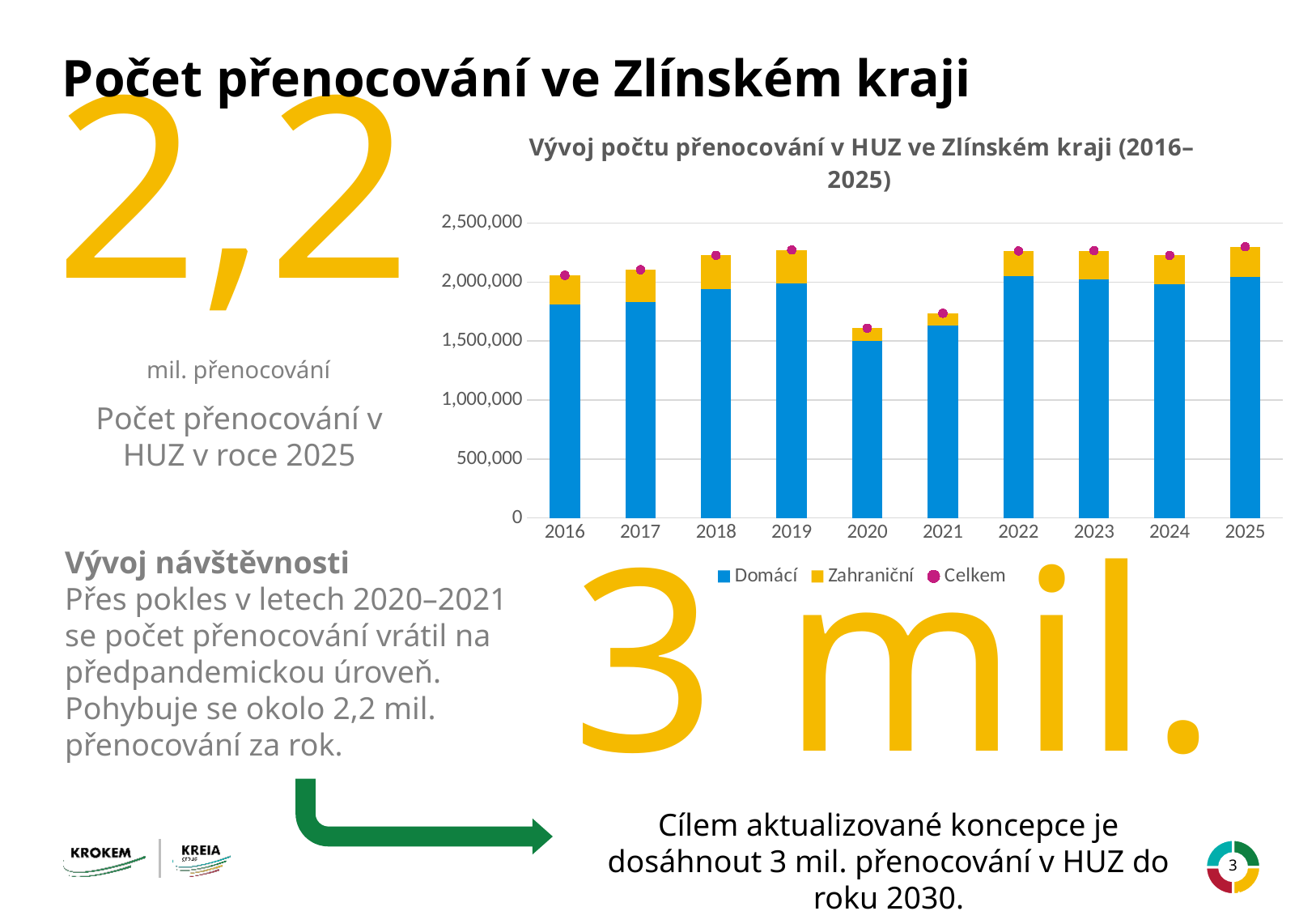
How many series does the chart legend list? 3 Do the total (Celkem) values rise or fall from 2016 to 2019? rise Is the total (Celkem) value for 2020 greater or less than 2,000,000? less What kind of chart is shown on the slide? bar chart What is the title of the chart? Vývoj počtu přenocování v HUZ ve Zlínském kraji (2016–2025) Which year has the lowest Domácí value? 2020 Which year has the lowest total (Celkem) number of overnight stays? 2020 Which year has the larger total (Celkem) value, 2021 or 2022? 2022 Is the total (Celkem) value for 2019 greater or less than 2,000,000? greater How many years are shown on the x axis of the chart? 10 Is the Domácí value for 2020 greater or less than 1,000,000? greater Which year has the larger Domácí value, 2016 or 2020? 2016